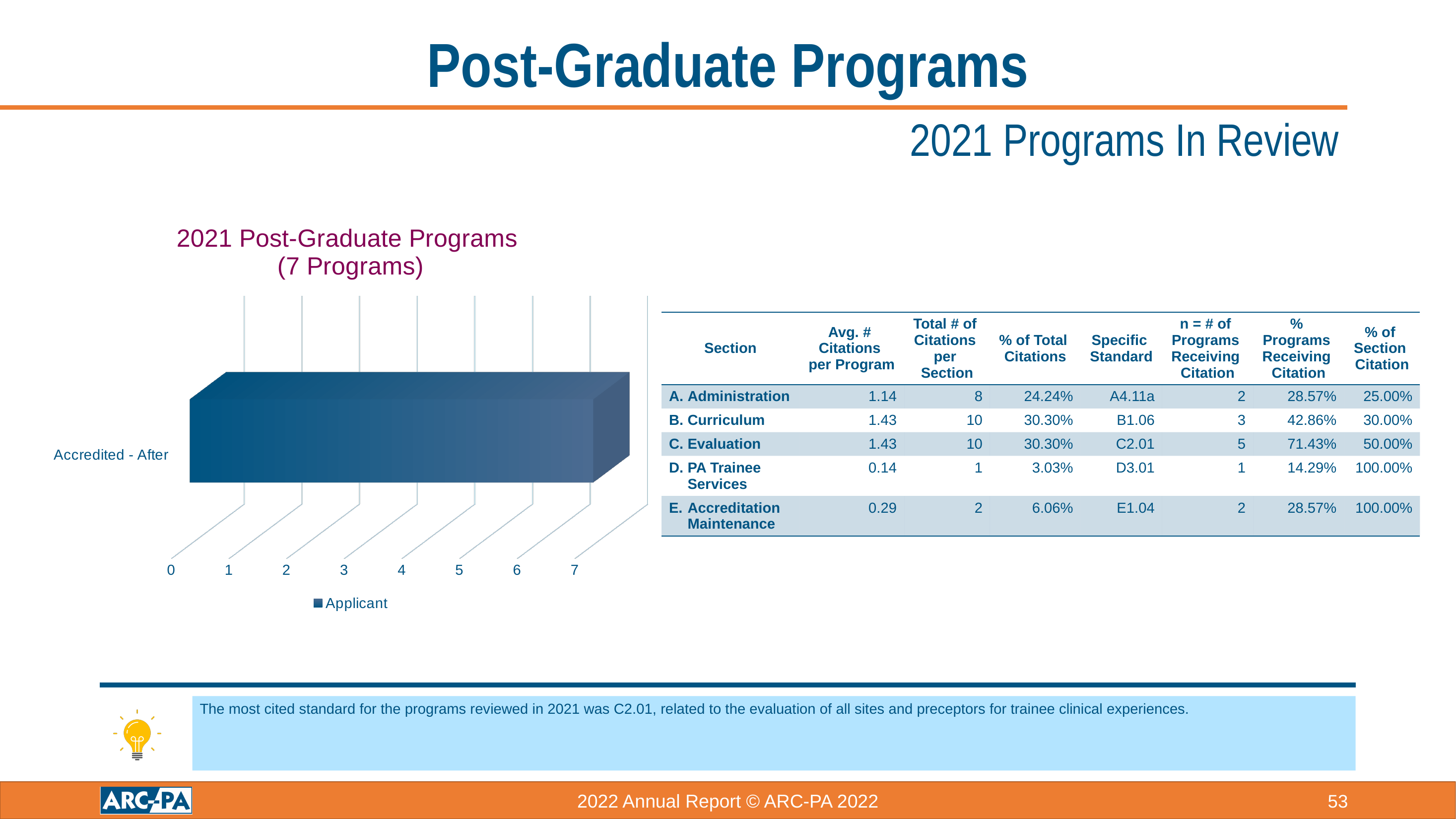
What series name appears in the chart legend? Applicant What kind of chart is shown on the slide? bar chart What is the value of the Applicant bar for Accredited - After? 7 Is the value for Accredited - After greater or less than 5? greater How many categories does the chart show? 1 How many series does the chart legend list? 1 What is the title of the chart? 2021 Post-Graduate Programs (7 Programs) What is the highest value shown on the chart's value axis? 7 Is the value for Accredited - After greater or less than 3? greater